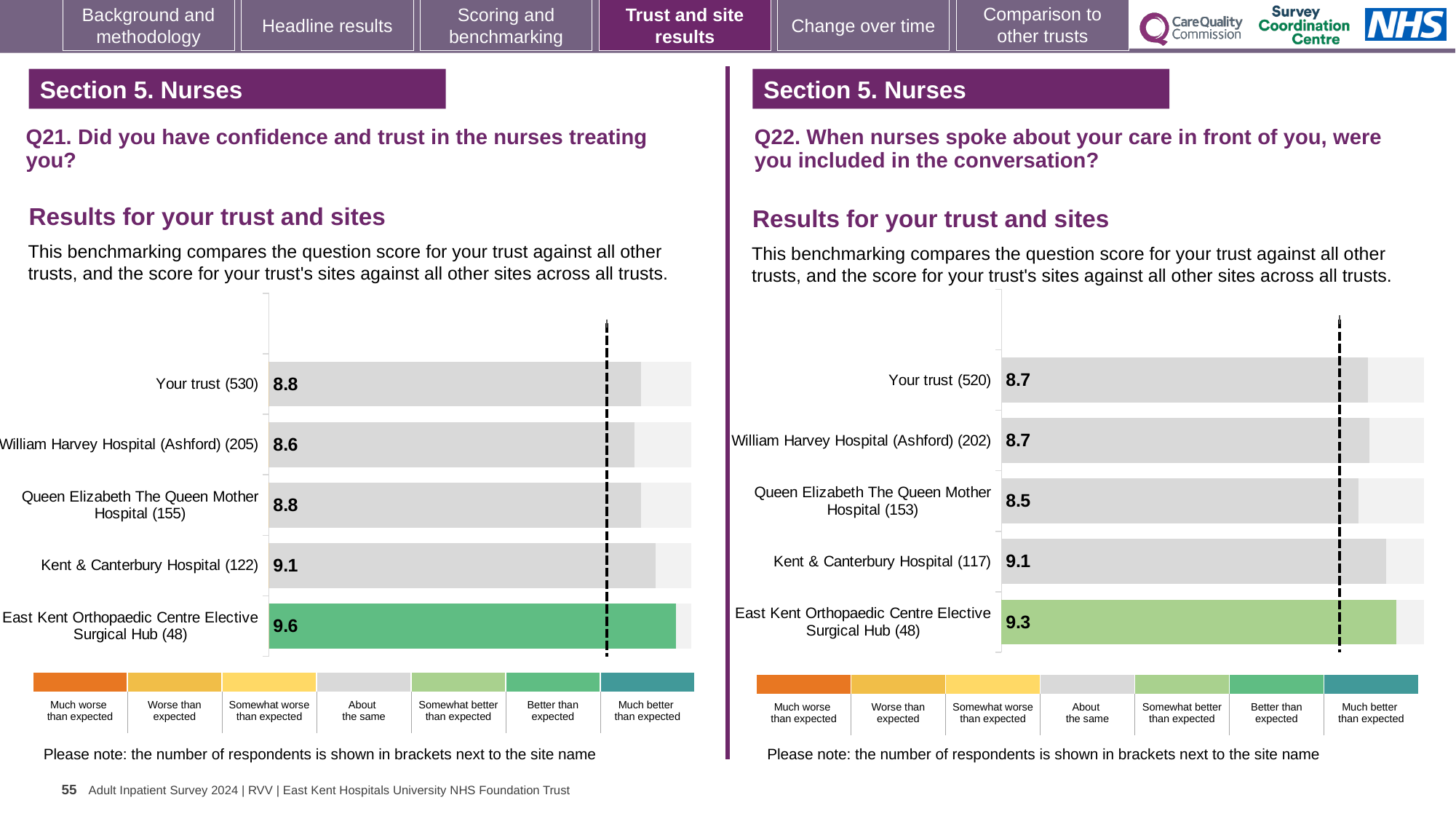
On the Q22 chart (right), what is the score for Queen Elizabeth The Queen Mother Hospital? 8.5 On the Q21 chart (left), what is the score for Kent & Canterbury Hospital? 9.1 On the Q22 chart (right), what is the difference between the scores for Kent & Canterbury Hospital and Your trust? 0.4 On the Q22 chart (right), which is larger: the score for Kent & Canterbury Hospital or the score for Your trust? Kent & Canterbury Hospital On the Q22 chart (right), what is the score for East Kent Orthopaedic Centre Elective Surgical Hub? 9.3 On the Q21 chart (left), what is the difference between the scores for East Kent Orthopaedic Centre Elective Surgical Hub and William Harvey Hospital (Ashford)? 1.0 On the Q21 chart (left), which site has the highest score? East Kent Orthopaedic Centre Elective Surgical Hub What type of chart is used on the Q22 chart (right)? Bar chart On the Q21 chart (left), which site has the lowest score? William Harvey Hospital (Ashford) On the Q22 chart (right), which site has the lowest score? Queen Elizabeth The Queen Mother Hospital On the Q21 chart (left), what is the score for Your trust? 8.8 On the Q21 chart (left), how many bars are plotted? 5